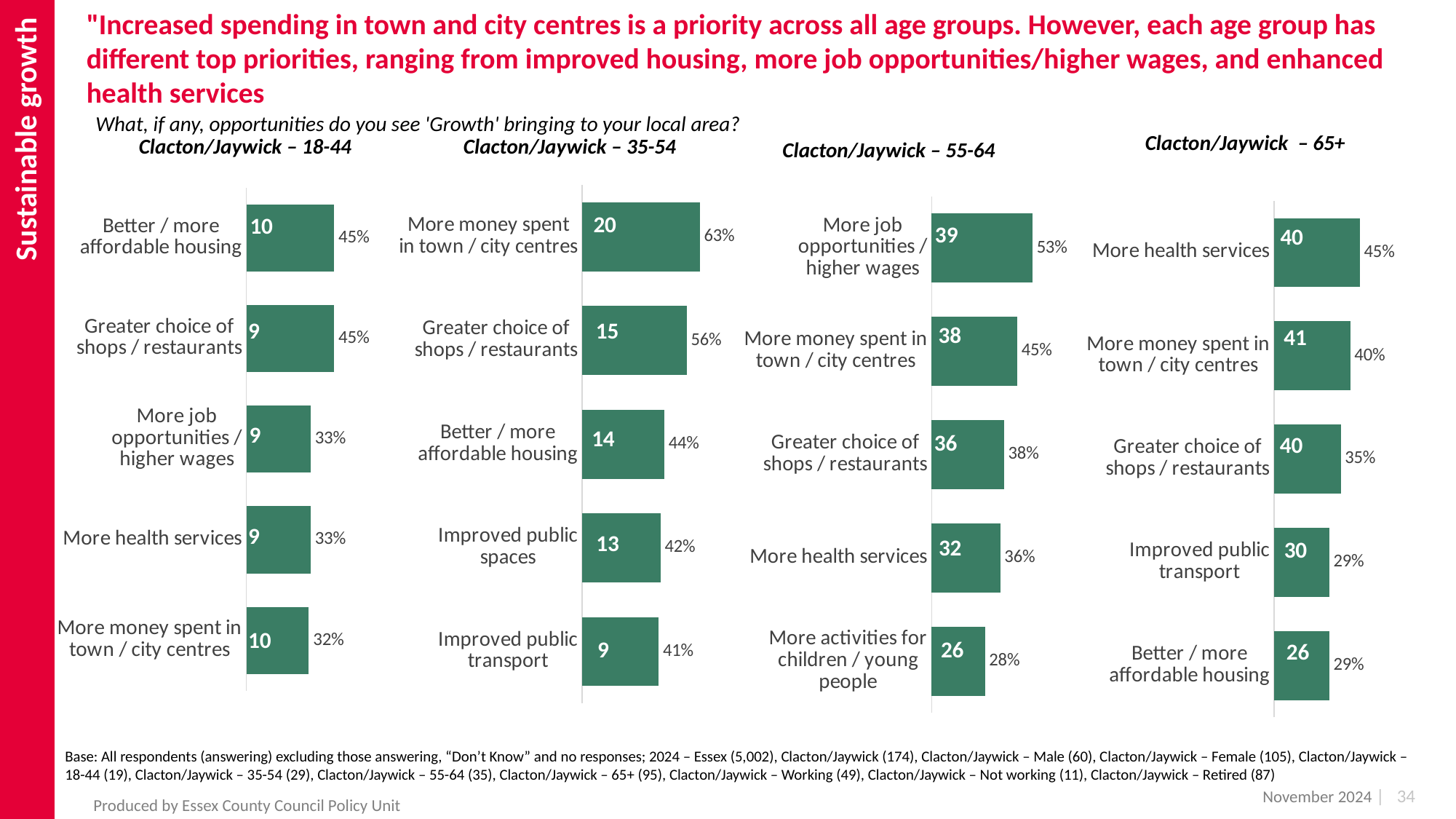
In the Clacton/Jaywick – 35-54 chart, which category has the highest percentage? More money spent in town / city centres How many categories are shown in the Clacton/Jaywick – 18-44 chart? 5 In the Clacton/Jaywick – 35-54 chart, what percentage is shown for 'More money spent in town / city centres'? 63% In the Clacton/Jaywick – 35-54 chart, what is the difference in percentage points between 'Greater choice of shops / restaurants' and 'Improved public transport'? 15 In the Clacton/Jaywick – 65+ chart, what percentage is shown for 'Improved public transport'? 29% In the Clacton/Jaywick – 55-64 chart, what count is printed inside the bar for 'More job opportunities / higher wages'? 39 In the Clacton/Jaywick – 55-64 chart, which is larger: the percentage for 'Greater choice of shops / restaurants' or for 'More health services'? Greater choice of shops / restaurants In the Clacton/Jaywick – 55-64 chart, which category has the lowest percentage? More activities for children / young people What type of chart is used for the Clacton/Jaywick – 65+ data? Bar chart In the Clacton/Jaywick – 65+ chart, what is the difference in percentage points between 'More health services' and 'More money spent in town / city centres'? 5 In the Clacton/Jaywick – 18-44 chart, what percentage is shown for 'Better / more affordable housing'? 45% How many charts are shown on the slide? 4